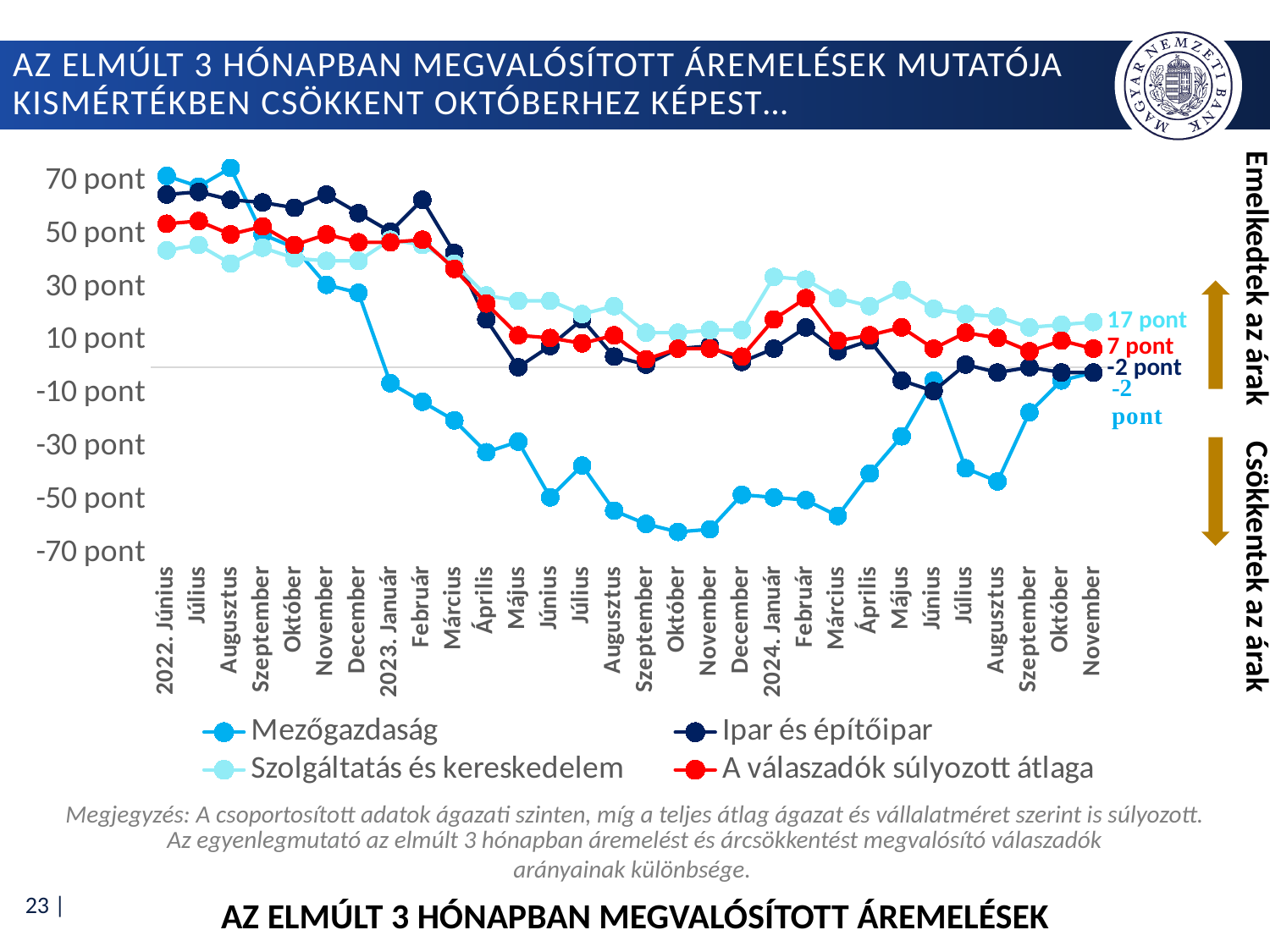
Is the value for Mezőgazdaság in June 2022 greater or less than 50 pont? greater What is the value for A válaszadók súlyozott átlaga in November 2024? 7 pont How many months are plotted along the x axis? 30 What kind of chart is shown on the slide? line chart What is the value for Ipar és építőipar in November 2024? -2 pont How many series does the legend list? 4 In October 2023, which is larger: the value for Mezőgazdaság or the value for Szolgáltatás és kereskedelem? Szolgáltatás és kereskedelem Which series has the highest value in November 2024? Szolgáltatás és kereskedelem What is the value for Szolgáltatás és kereskedelem in November 2024? 17 pont What is the difference between the November 2024 values of Szolgáltatás és kereskedelem and A válaszadók súlyozott átlaga? 10 pont Is the value for Mezőgazdaság in October 2023 greater or less than -50 pont? less Does the Mezőgazdaság series rise or fall from June 2022 to October 2023? fall